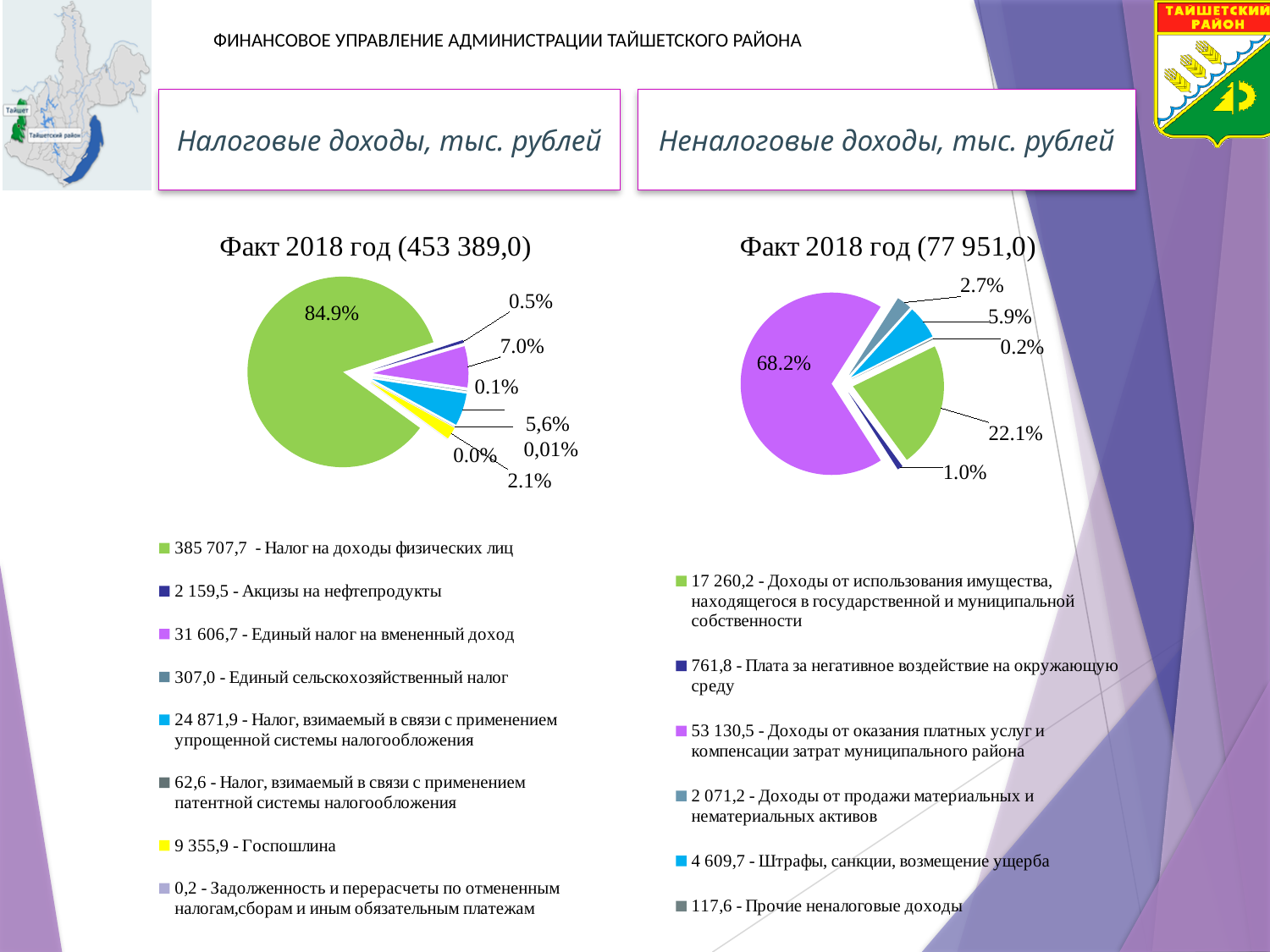
How many categories does the legend of the left chart (Налоговые доходы) list? 8 On the left chart (Налоговые доходы), which category has the largest value? Налог на доходы физических лиц What type of chart is used on the left chart titled "Налоговые доходы, тыс. рублей"? pie chart What total is shown in the title of the right chart (Неналоговые доходы) for Факт 2018 год? 77 951,0 On the right chart (Неналоговые доходы), what share of the pie does "Доходы от оказания платных услуг и компенсации затрат муниципального района" take? 68.2% On the left chart (Налоговые доходы), what is the difference between "Налог на доходы физических лиц" and "Единый налог на вмененный доход"? 354 101,0 On the left chart (Налоговые доходы), what is the value for "Налог на доходы физических лиц"? 385 707,7 How many categories does the legend of the right chart (Неналоговые доходы) list? 6 On the left chart (Налоговые доходы), what share of the pie does "Налог на доходы физических лиц" take? 84.9% On the right chart (Неналоговые доходы), which is larger: "Доходы от использования имущества" or "Доходы от продажи материальных и нематериальных активов"? Доходы от использования имущества On the right chart (Неналоговые доходы), which category has the smallest value? Прочие неналоговые доходы On the right chart (Неналоговые доходы), what is the value for "Штрафы, санкции, возмещение ущерба"? 4 609,7